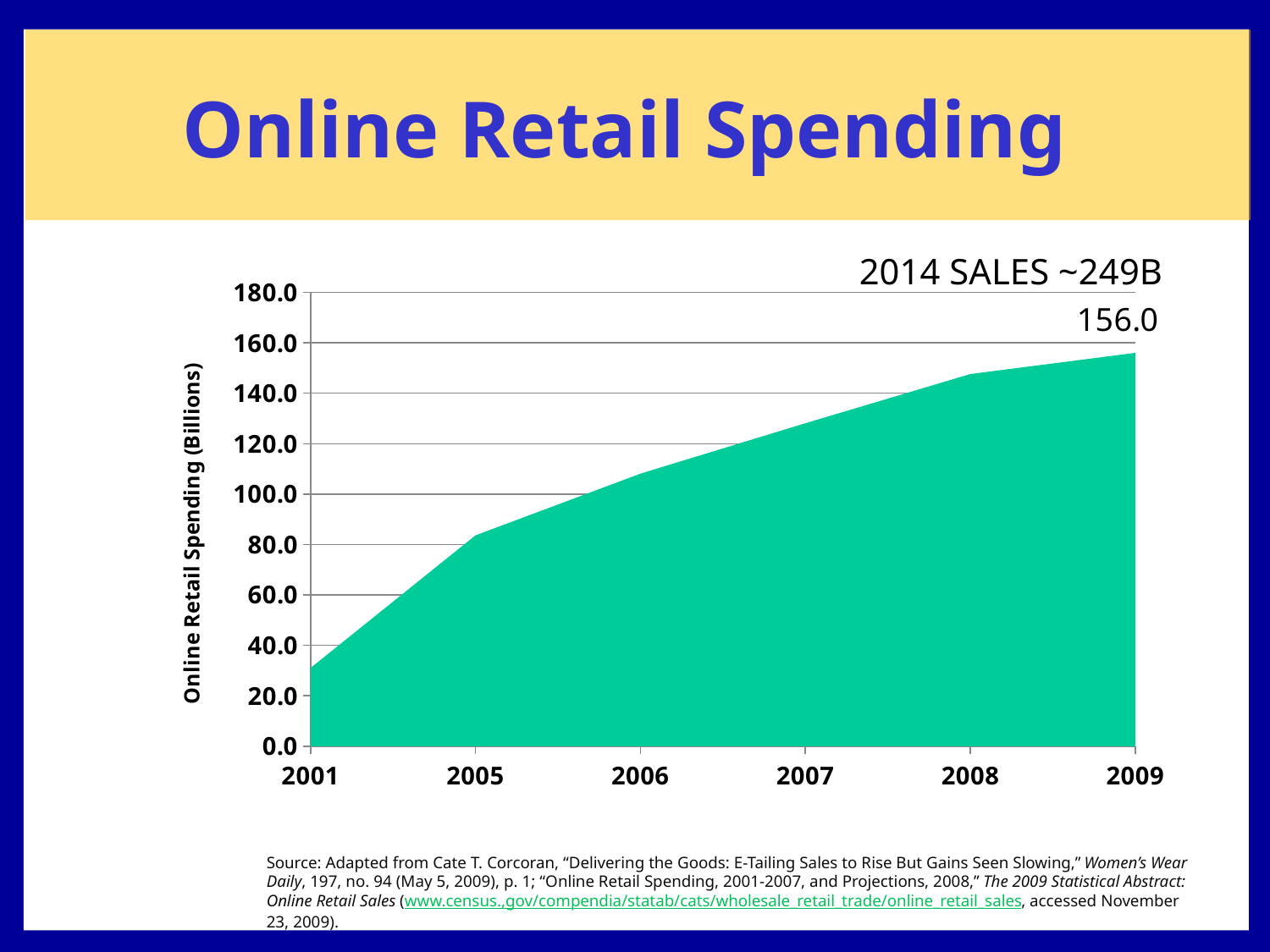
How many years are shown on the x axis? 6 What is the value for 2009 on the chart? 156.0 Do the values rise or fall from 2001 to 2009? Rise Is the value for 2001 greater or less than 40.0? less Is the value for 2008 greater or less than 160.0? less Which is larger, the value for 2008 or the value for 2005? 2008 Is the value for 2005 greater or less than 100.0? less Which year has the highest online retail spending? 2009 What kind of chart is shown on the slide? Area chart What is the label on the y axis? Online Retail Spending (Billions) Which year has the lowest online retail spending? 2001